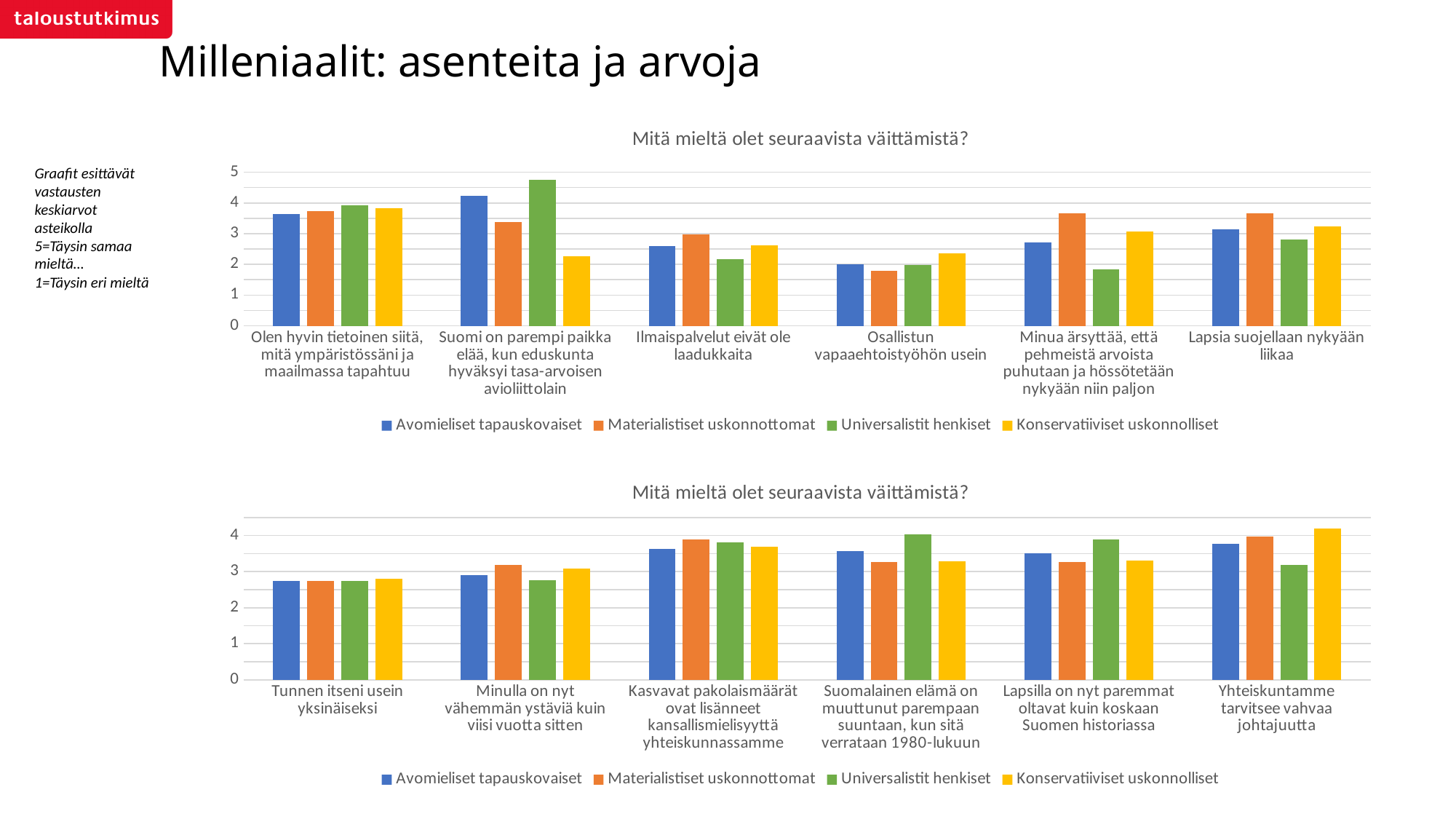
In the bottom chart, for the statement 'Yhteiskuntamme tarvitsee vahvaa johtajuutta', which series has the highest value? Konservatiiviset uskonnolliset In the top chart, for the statement 'Minua ärsyttää, että pehmeistä arvoista puhutaan ja hössötetään nykyään niin paljon', which series has the lowest value? Universalistit henkiset In the bottom chart, which colour represents the series Universalistit henkiset? Green In the top chart, is the value for Universalistit henkiset on 'Suomi on parempi paikka elää, kun eduskunta hyväksyi tasa-arvoisen avioliittolain' greater or less than 4? greater In the bottom chart, is the value for Konservatiiviset uskonnolliset on 'Yhteiskuntamme tarvitsee vahvaa johtajuutta' greater or less than 4? greater In the top chart, for the statement 'Suomi on parempi paikka elää, kun eduskunta hyväksyi tasa-arvoisen avioliittolain', which series has the highest value? Universalistit henkiset What kind of chart is the top chart? Bar chart In the bottom chart, for 'Minulla on nyt vähemmän ystäviä kuin viisi vuotta sitten', which is larger: Materialistiset uskonnottomat or Universalistit henkiset? Materialistiset uskonnottomat In the top chart, how many statements (categories) are shown on the x axis? 6 In the bottom chart, how many series does the legend list? 4 In the top chart, is the value for Konservatiiviset uskonnolliset on 'Suomi on parempi paikka elää, kun eduskunta hyväksyi tasa-arvoisen avioliittolain' greater or less than 3? less In the top chart, for 'Minua ärsyttää, että pehmeistä arvoista puhutaan ja hössötetään nykyään niin paljon', which is larger: Materialistiset uskonnottomat or Avomieliset tapauskovaiset? Materialistiset uskonnottomat